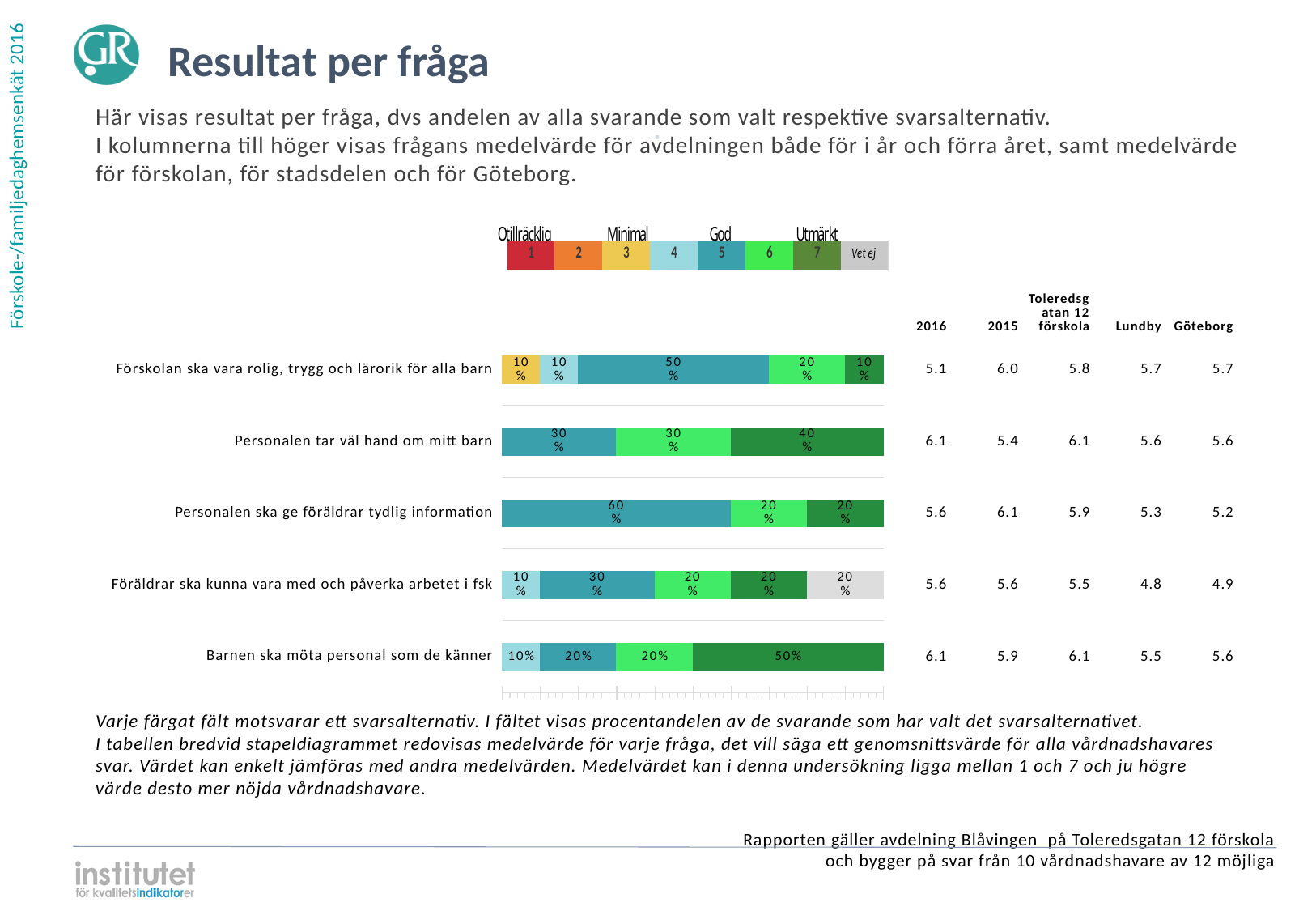
For "Personalen tar väl hand om mitt barn", what is the difference between the share for option 7 and the share for option 5? 10 percentage points What kind of chart is shown on the slide? Stacked bar chart Which question has the largest share of respondents choosing option 7? Barnen ska möta personal som de känner For "Förskolan ska vara rolig, trygg och lärorik för alla barn", which has the larger share: option 5 or option 6? Option 5 How many questions (categories) are plotted in the bar chart? 5 What percentage of respondents chose option 7 for "Barnen ska möta personal som de känner"? 50% For "Personalen tar väl hand om mitt barn", what is the combined share of options 6 and 7? 70% What percentage answered "Vet ej" for "Föräldrar ska kunna vara med och påverka arbetet i fsk"? 20% What label does the legend give to answer option 7? Utmärkt What percentage chose option 3 for "Förskolan ska vara rolig, trygg och lärorik för alla barn"? 10% How many answer options does the legend above the chart list? 8 What percentage chose option 5 for "Personalen ska ge föräldrar tydlig information"? 60%